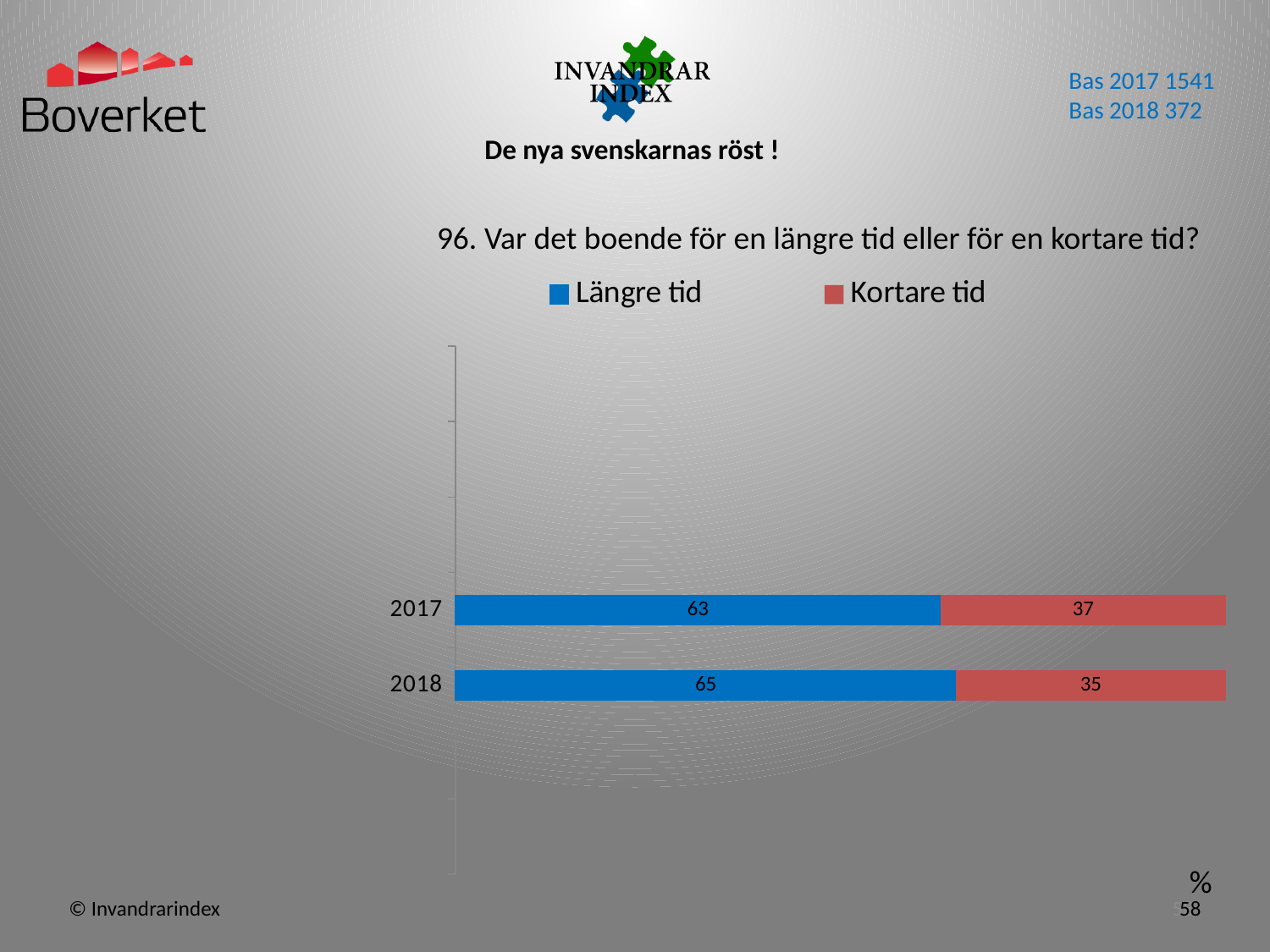
Which year has the higher value for Längre tid? 2018 What kind of chart is shown on the slide? Stacked bar chart Which year has the lower value for Kortare tid? 2018 What is the difference between the Längre tid values for 2018 and 2017? 2 What is the value for Längre tid in 2018? 65 In 2017, which is larger: Längre tid or Kortare tid? Längre tid What is the value for Längre tid in 2017? 63 How many years (categories) are shown in the chart? 2 What is the value for Kortare tid in 2017? 37 How many series does the legend list? 2 What is the total of the stacked bar for 2018? 100 What is the value for Kortare tid in 2018? 35